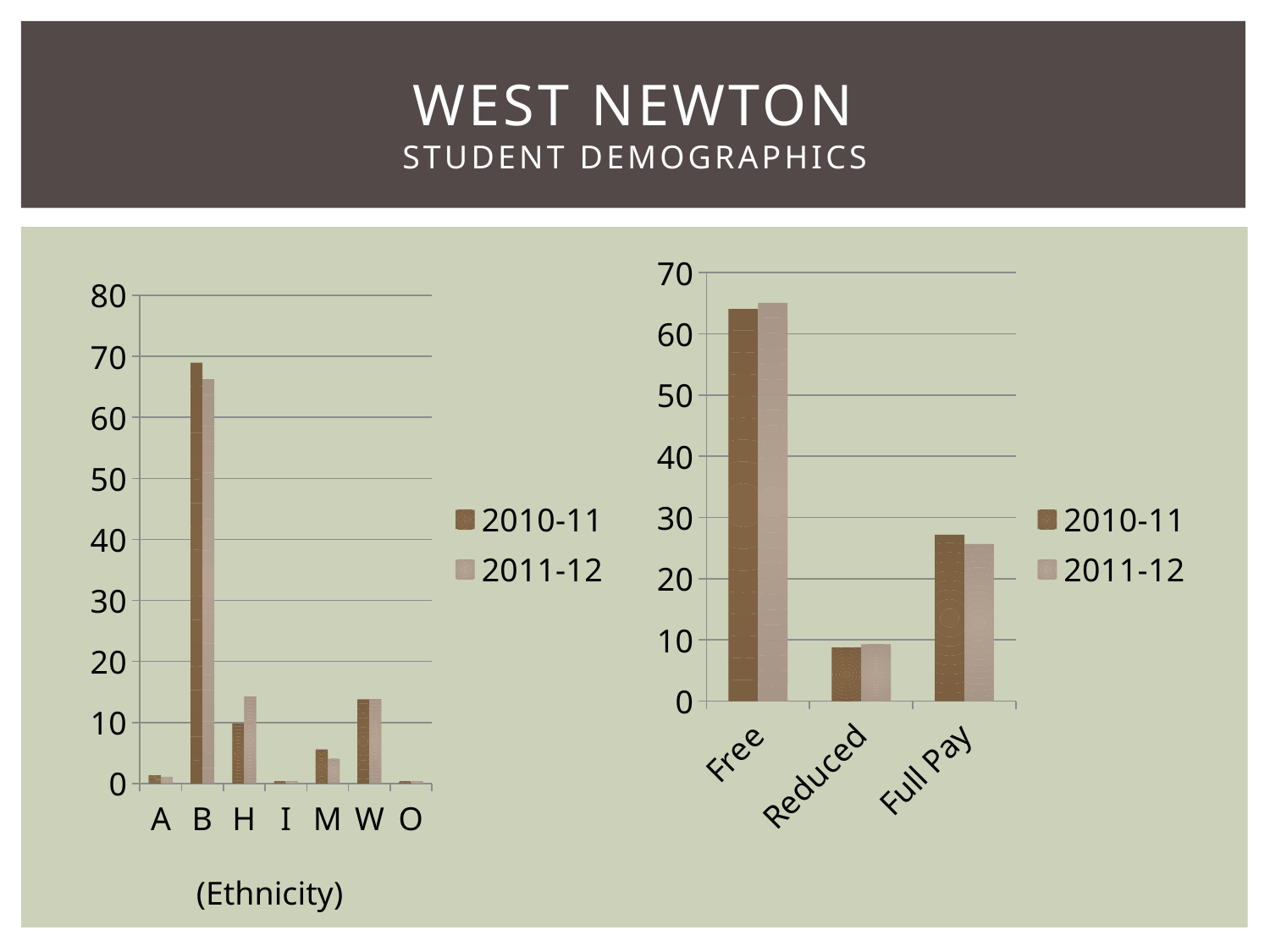
On the (Ethnicity) chart on the left, which is larger for H: the 2010-11 value or the 2011-12 value? 2011-12 On the (Ethnicity) chart on the left, is the 2011-12 value for H greater or less than 10? greater On the chart on the right, is the 2010-11 value for Full Pay greater or less than 30? less On the chart on the right, which category has the lowest value for 2010-11? Reduced On the (Ethnicity) chart on the left, how many categories are shown on the x axis? 7 On the (Ethnicity) chart on the left, is the 2010-11 value for B greater or less than 60? greater On the chart on the right, which category has the highest value for 2011-12? Free On the (Ethnicity) chart on the left, how many series does the legend list? 2 What kind of chart is the chart on the right of the slide? bar chart On the chart on the right, what are the two series listed in the legend? 2010-11 and 2011-12 On the (Ethnicity) chart on the left, which category has the highest value for 2010-11? B